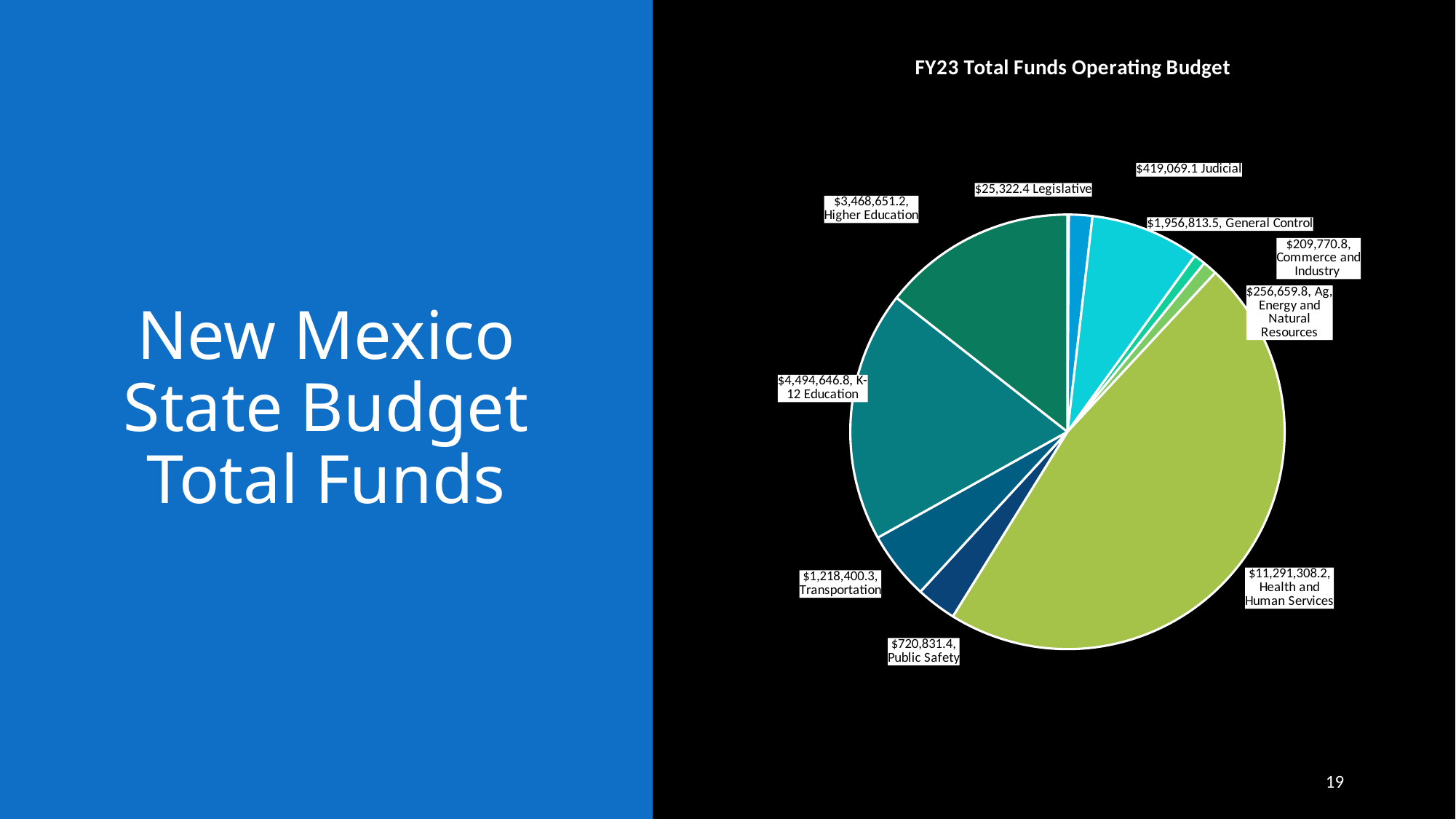
Which category has the smallest slice of the pie? Legislative What is the title of the pie chart? FY23 Total Funds Operating Budget Which category has the largest slice of the pie? Health and Human Services How many slices does the pie chart have? 10 What type of chart is shown on the slide? Pie chart What is the value shown for Commerce and Industry? $209,770.8 Which is larger, Transportation or Public Safety? Transportation What is the value shown for Legislative? $25,322.4 What is the value shown for K-12 Education? $4,494,646.8 What is the difference between the Judicial value and the Legislative value? $393,746.7 What is the difference between the K-12 Education value and the Higher Education value? $1,025,995.6 What is the value shown for Health and Human Services? $11,291,308.2